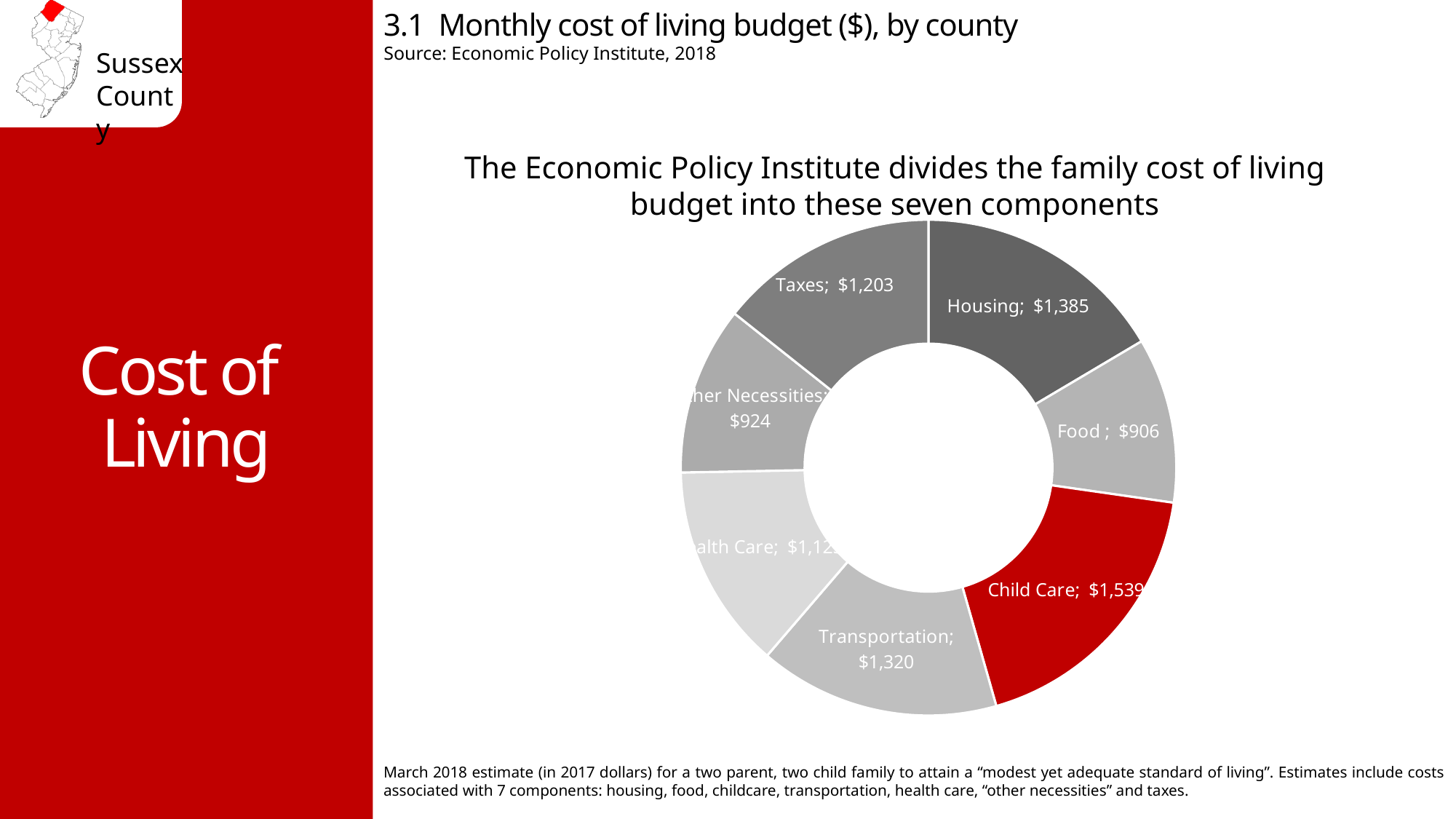
Which component's slice is coloured red? Child Care What is the difference between the Child Care cost and the Housing cost? $154 Which component has the highest monthly cost? Child Care What is the monthly Food cost shown on the chart? $906 How many components are shown in the chart? 7 What is the monthly Transportation cost shown on the chart? $1,320 Which is larger, the Taxes cost or the Transportation cost? Transportation What type of chart is shown on the slide? Pie (doughnut) chart Which component has the lowest monthly cost? Food What is the monthly Child Care cost shown on the chart? $1,539 What is the monthly Housing cost shown on the chart? $1,385 What is the monthly Taxes cost shown on the chart? $1,203